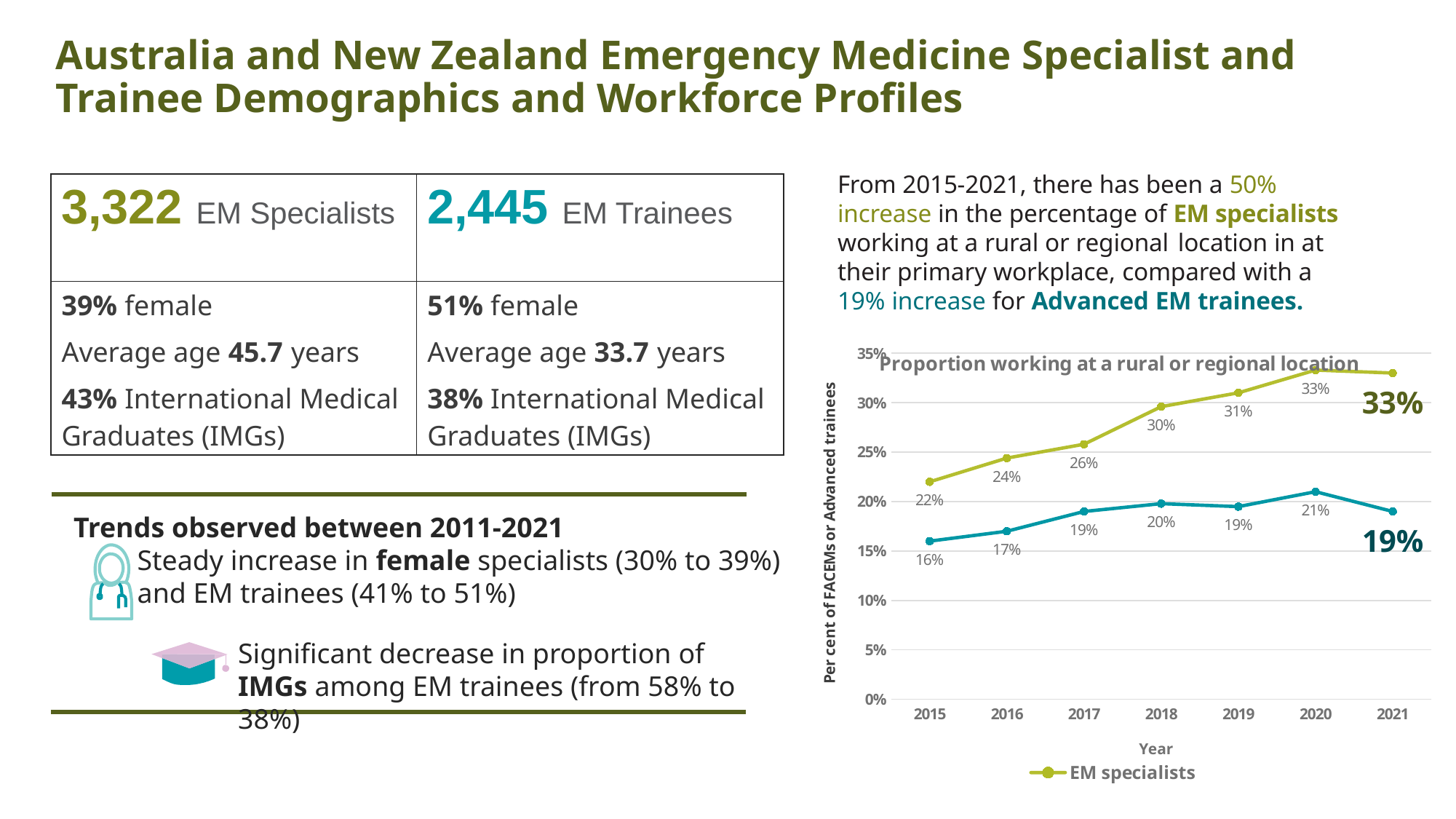
What kind of chart is shown on the slide? line chart In which year was the proportion of Advanced trainees working at a rural or regional location lowest? 2015 What is the difference between the EM specialists value and the Advanced trainees value in 2021? 14% What was the proportion of EM specialists working at a rural or regional location in 2015? 22% Does the EM specialists line generally rise or fall from 2015 to 2021? rise Which series had the higher value in 2017, EM specialists or Advanced trainees? EM specialists What was the proportion of Advanced trainees working at a rural or regional location in 2020? 21% How many years are plotted along the x axis of the chart? 7 How many entries does the chart's legend list? 1 What was the proportion of Advanced trainees working at a rural or regional location in 2021? 19% What was the proportion of EM specialists working at a rural or regional location in 2018? 30% What is the title of the chart? Proportion working at a rural or regional location